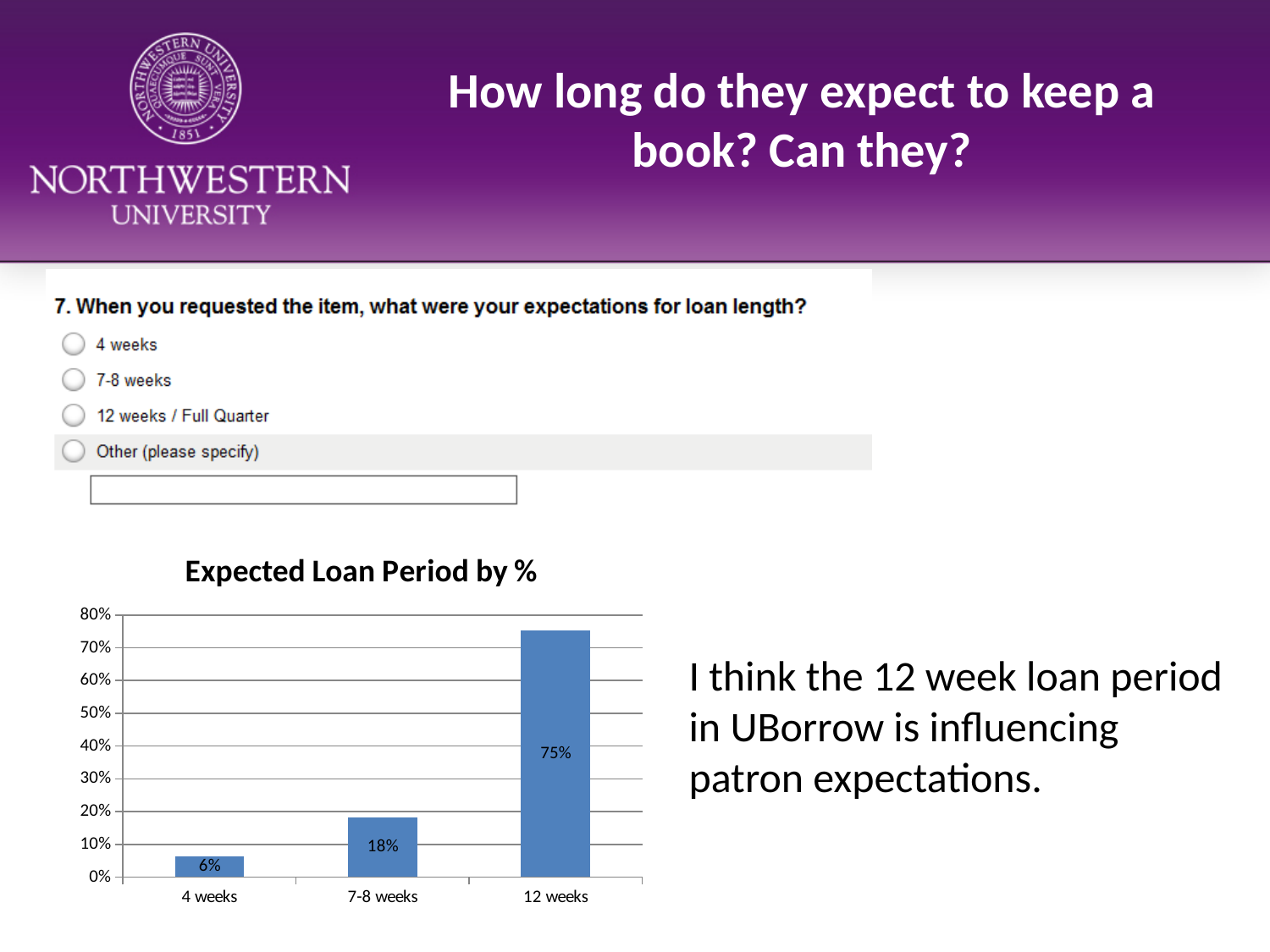
Which category has the lowest value in the Expected Loan Period by % chart? 4 weeks Do the values rise or fall from left to right along the x axis in the Expected Loan Period by % chart? rise What kind of chart is the Expected Loan Period by % chart? bar chart Is the value for 12 weeks in the Expected Loan Period by % chart greater or less than 70%? greater What is the difference between the values for 12 weeks and 7-8 weeks in the Expected Loan Period by % chart? 57% What is the value for 7-8 weeks in the Expected Loan Period by % chart? 18% Which category has the highest value in the Expected Loan Period by % chart? 12 weeks What is the value for 4 weeks in the Expected Loan Period by % chart? 6% What is the value for 12 weeks in the Expected Loan Period by % chart? 75% Which is larger in the Expected Loan Period by % chart, the value for 7-8 weeks or the value for 4 weeks? 7-8 weeks What is the difference between the values for 7-8 weeks and 4 weeks in the Expected Loan Period by % chart? 12% How many categories are shown in the Expected Loan Period by % chart? 3